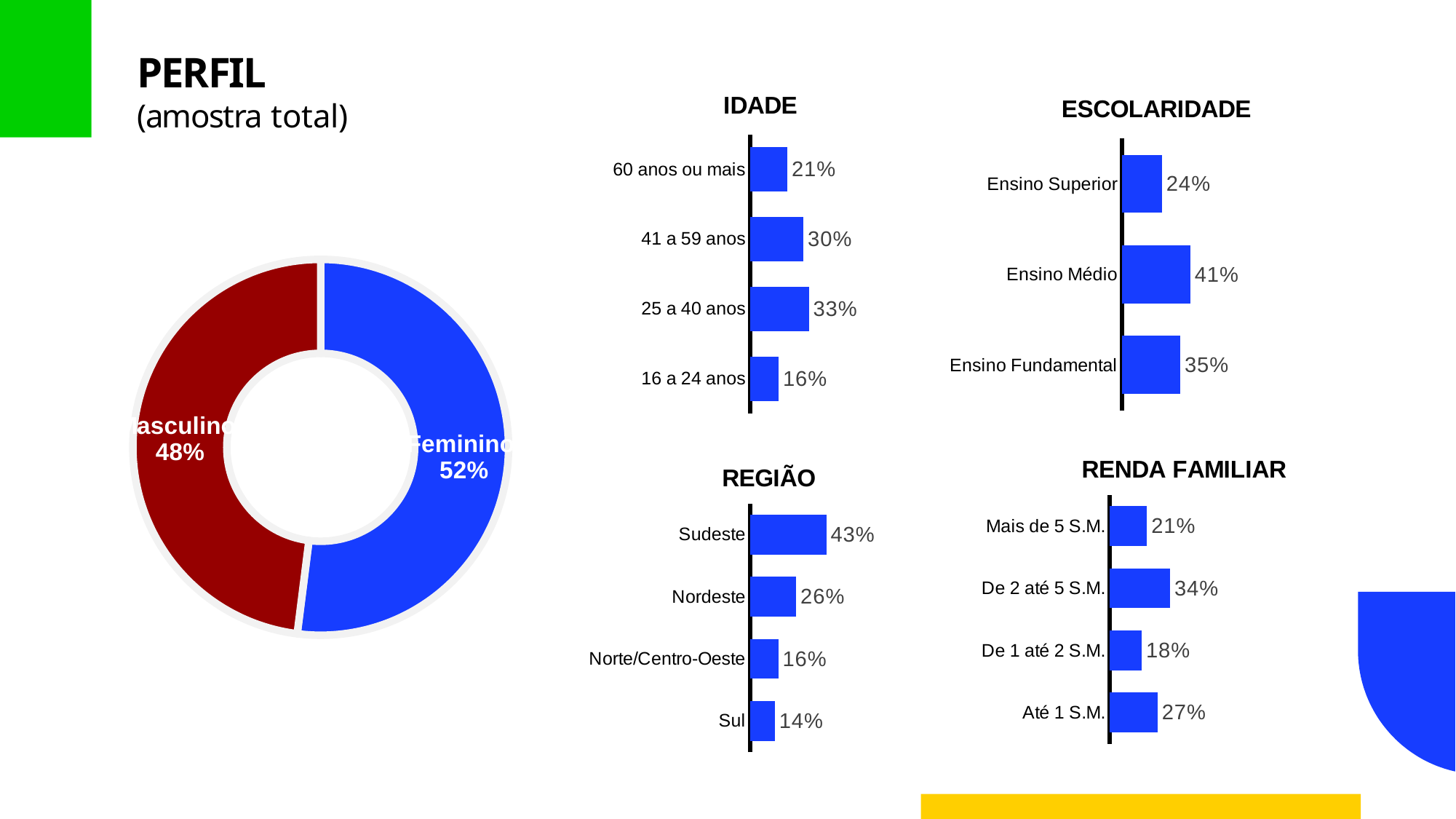
In the REGIÃO chart, how many regions are shown? 4 In the IDADE chart, what is the total of 41 a 59 anos and 60 anos ou mais? 51% In the IDADE chart, what is the value for 25 a 40 anos? 33% In the ESCOLARIDADE chart, what is the difference between Ensino Fundamental and Ensino Superior? 11% In the ESCOLARIDADE chart, what is the value for Ensino Médio? 41% In the REGIÃO chart, which region has the highest value? Sudeste In the REGIÃO chart, what is the value for Sul? 14% In the RENDA FAMILIAR chart, which is larger, Até 1 S.M. or Mais de 5 S.M.? Até 1 S.M. In the donut chart on the left, what share is Feminino? 52% What kind of chart is the REGIÃO chart? Bar chart In the RENDA FAMILIAR chart, what is the value for De 2 até 5 S.M.? 34% In the IDADE chart, which age group has the lowest value? 16 a 24 anos